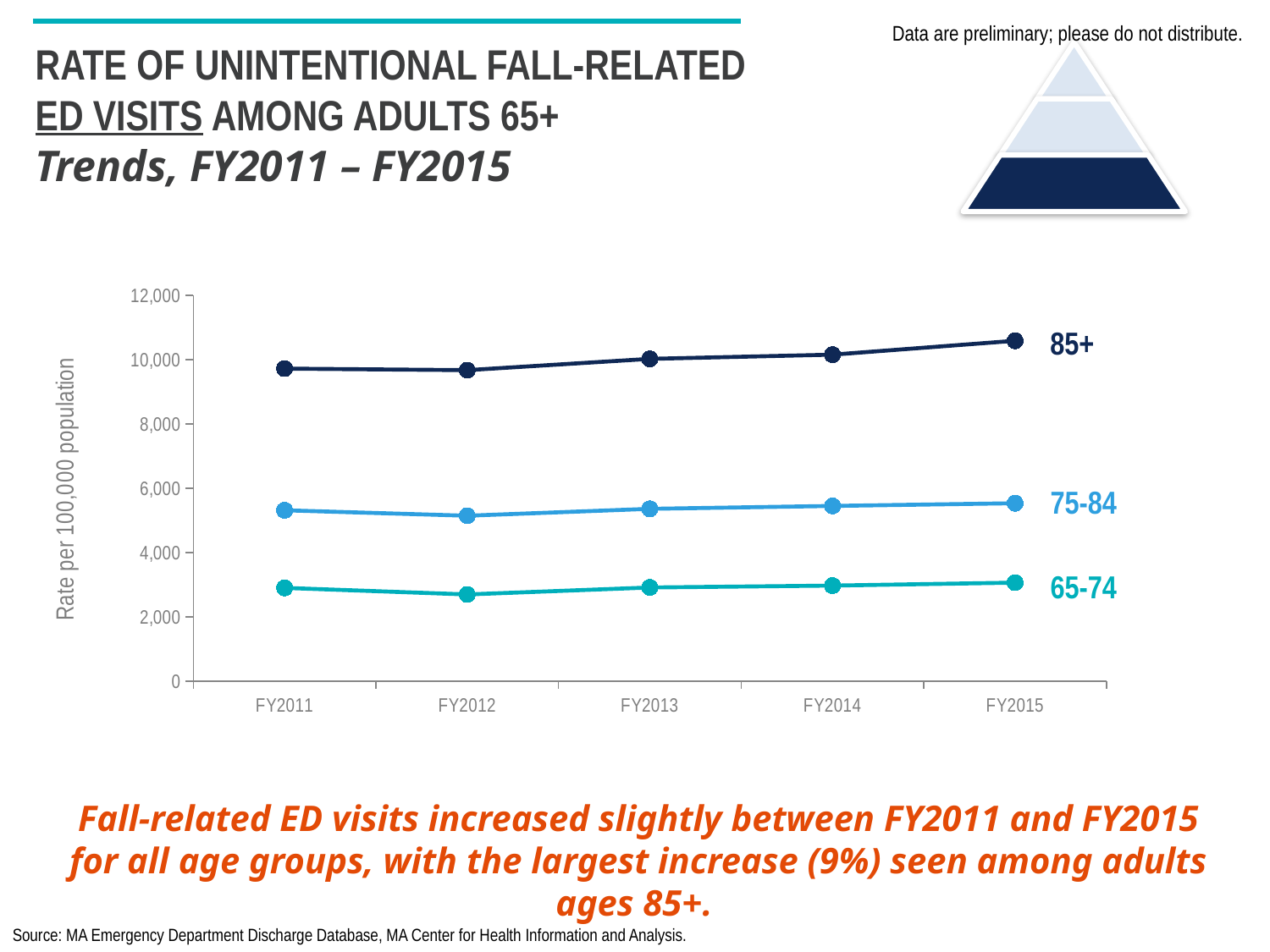
Is the value for the 85+ age group in FY2011 greater or less than 10,000? less What is the label on the y axis of the chart? Rate per 100,000 population Is the value for the 75-84 age group in FY2013 greater or less than 6,000? less Which age group has the lowest rate of fall-related ED visits in FY2011? 65-74 How many fiscal years are shown along the x axis? 5 Does the rate for the 85+ age group rise or fall from FY2011 to FY2015? rise Which age group has the highest rate of fall-related ED visits in FY2015? 85+ Is the value for the 65-74 age group in FY2012 greater or less than 4,000? less What kind of chart is shown on the slide? line chart Which is larger in FY2014, the value for the 75-84 age group or the 65-74 age group? 75-84 How many age-group lines are plotted on the chart? 3